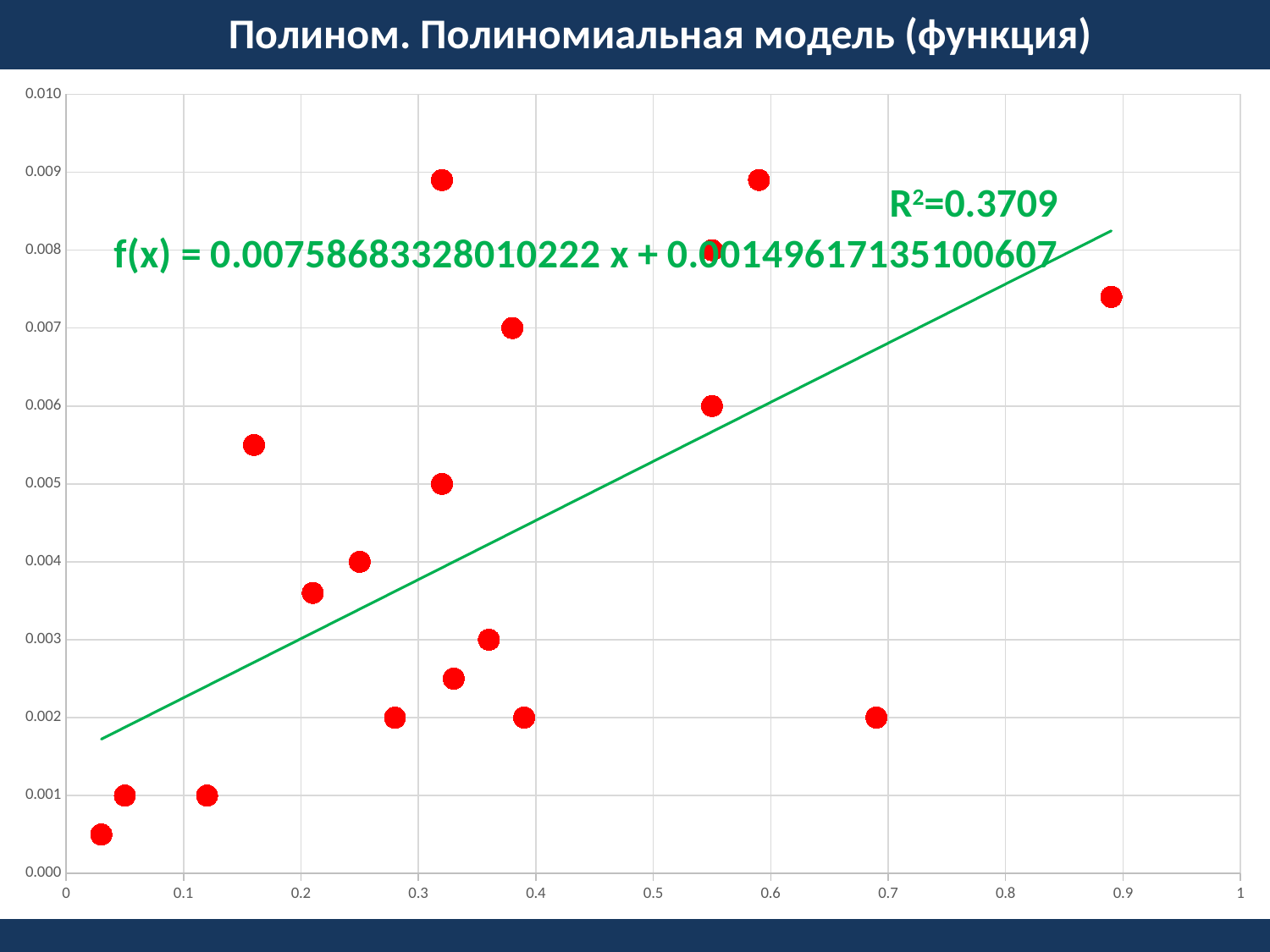
What is the intercept in the fitted function f(x) shown on the chart? 0.00149617135100607 Is the value of the point at x ≈ 0.69 greater or less than 0.003? less What R² value is printed on the chart? 0.3709 Is the value of the point at x ≈ 0.89 greater or less than 0.007? greater What is the maximum value shown on the y axis? 0.010 What is the title of the slide? Полином. Полиномиальная модель (функция) Does the green trend line rise or fall as x increases? rises Is the value of the point at x ≈ 0.16 greater or less than 0.005? greater What colour are the data points on the chart? red What kind of chart is shown on the slide? scatter chart How many data points are plotted on the chart? 18 What is the slope coefficient in the fitted function f(x) shown on the chart? 0.00758683328010222